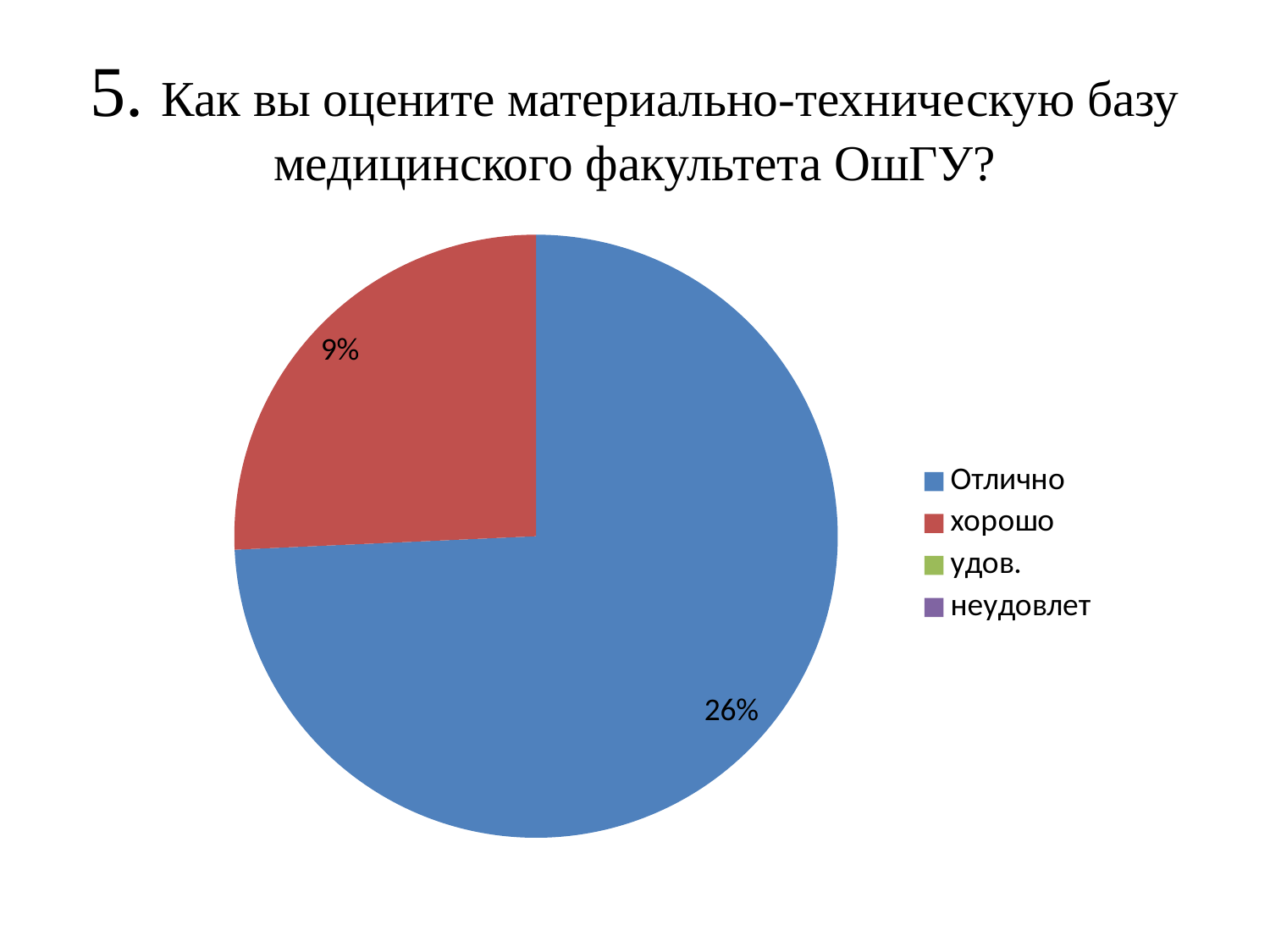
Which legend entry is shown in red? хорошо Which category has the largest slice in the pie chart? Отлично What is the difference between the labelled values for Отлично and хорошо? 17% What colour is the Отлично slice in the pie chart? Blue How many entries does the legend of the chart list? 4 What kind of chart is shown on the slide? Pie chart What value is shown for the Отлично slice of the pie chart? 26% Which is larger, the slice for Отлично or the slice for хорошо? Отлично How many slices are visibly drawn in the pie chart? 2 What value is shown for the хорошо slice of the pie chart? 9%